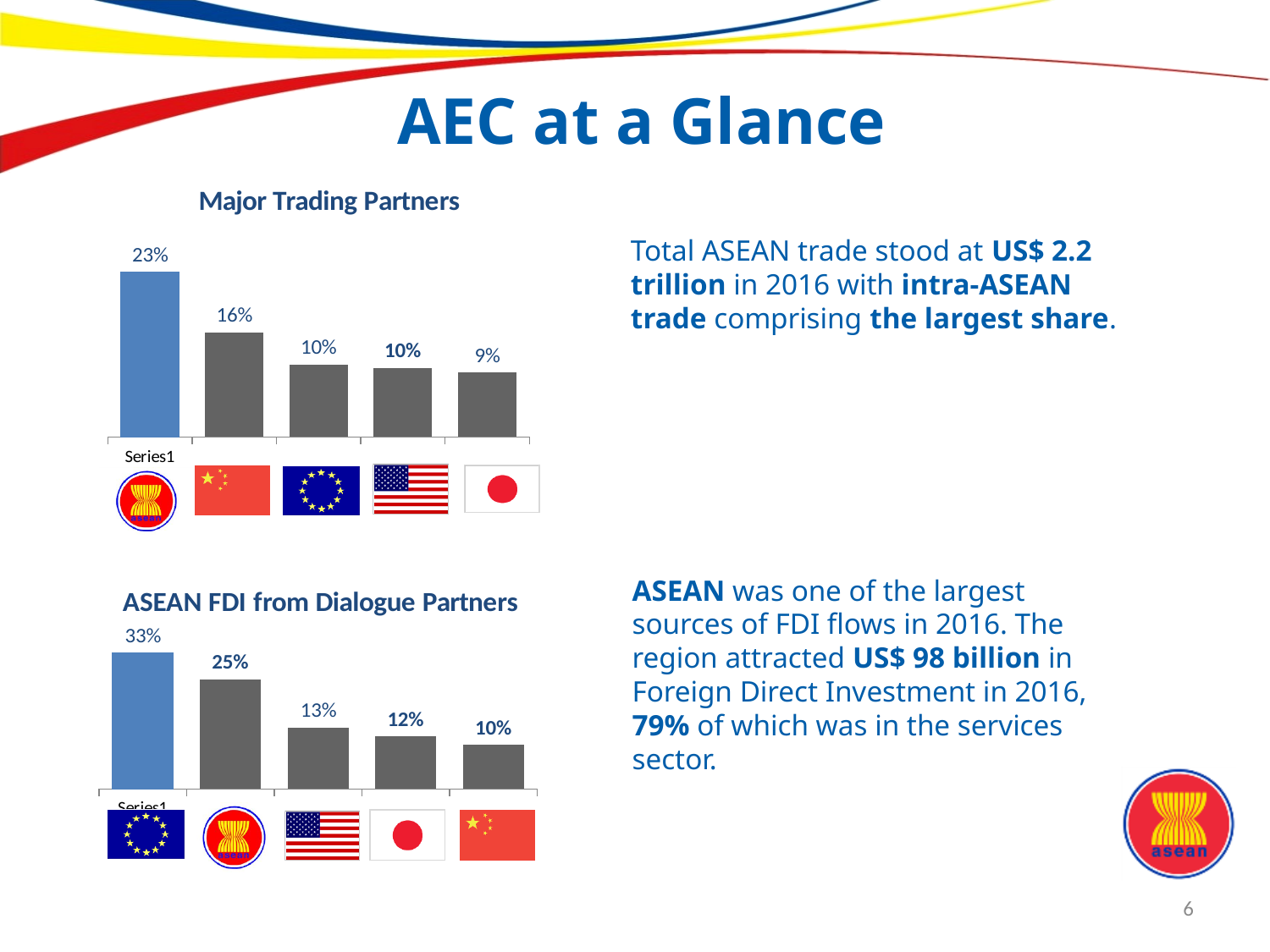
In the Major Trading Partners chart, what is the lowest value shown? 9% What kind of chart is the Major Trading Partners chart? Bar chart In the Major Trading Partners chart, what is the highest value shown? 23% In the Major Trading Partners chart, what value is shown above the first (blue) bar? 23% In the Major Trading Partners chart, what value is shown above the bar with the Japanese flag? 9% How many bars are plotted in the Major Trading Partners chart? 5 In the ASEAN FDI from Dialogue Partners chart, what is the difference between the highest value (33%) and the lowest value (10%)? 23 percentage points Which is larger: the first bar in the Major Trading Partners chart or the first bar in the ASEAN FDI from Dialogue Partners chart? The first bar in the ASEAN FDI from Dialogue Partners chart (33%) In the Major Trading Partners chart, what is the difference between the first bar (23%) and the second bar (16%)? 7 percentage points In the ASEAN FDI from Dialogue Partners chart, what is the highest value shown? 33% In the ASEAN FDI from Dialogue Partners chart, what value is shown above the second bar? 25% In the ASEAN FDI from Dialogue Partners chart, do the values rise or fall from left to right? Fall